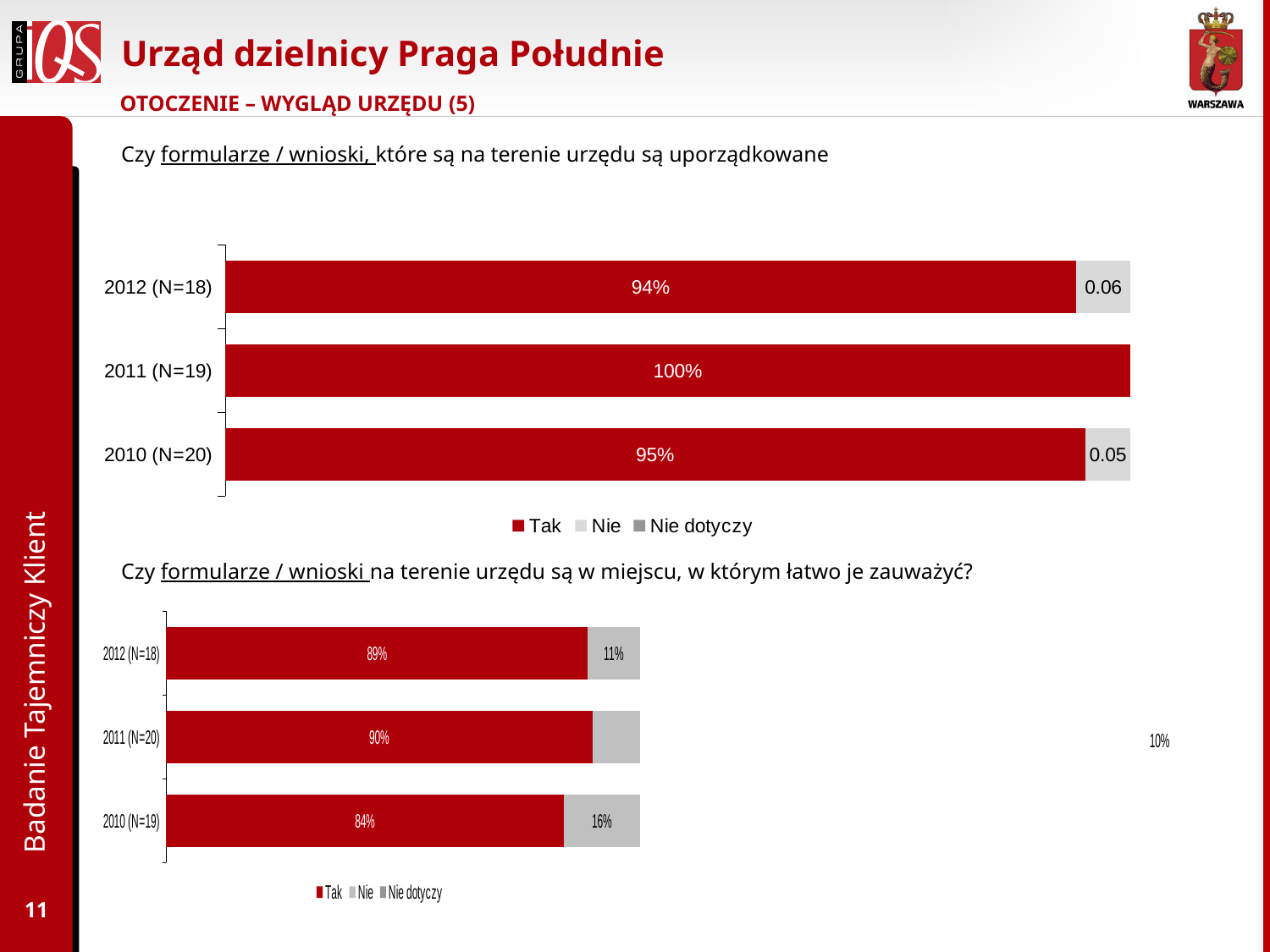
In the bottom chart (about whether forms are easy to notice), what is the difference between the 'Tak' values for 2011 (N=20) and 2010 (N=19)? 6 percentage points In the bottom chart (about whether forms are easy to notice), what is the 'Tak' value for 2010 (N=19)? 84% In the top chart (about whether forms are organised), which year has the highest 'Tak' value? 2011 (N=19) In the top chart (about whether forms are organised), how many series does the legend list? 3 In the bottom chart (about whether forms are easy to notice), which year has the lowest 'Tak' value? 2010 (N=19) What type of chart is the top chart on the slide? Stacked bar chart In the bottom chart (about whether forms are easy to notice), what is the 'Nie' value for 2012 (N=18)? 11% In the top chart (about whether forms are organised), what is the 'Tak' value for 2012 (N=18)? 94% In the top chart (about whether forms are organised), what label is shown on the 'Nie' segment for 2010 (N=20)? 0.05 In the top chart (about whether forms are organised), what is the 'Tak' value for 2011 (N=19)? 100% In the bottom chart (about whether forms are easy to notice), is the 'Tak' value larger for 2012 (N=18) or 2010 (N=19)? 2012 (N=18) In the bottom chart (about whether forms are easy to notice), how many year categories are shown? 3